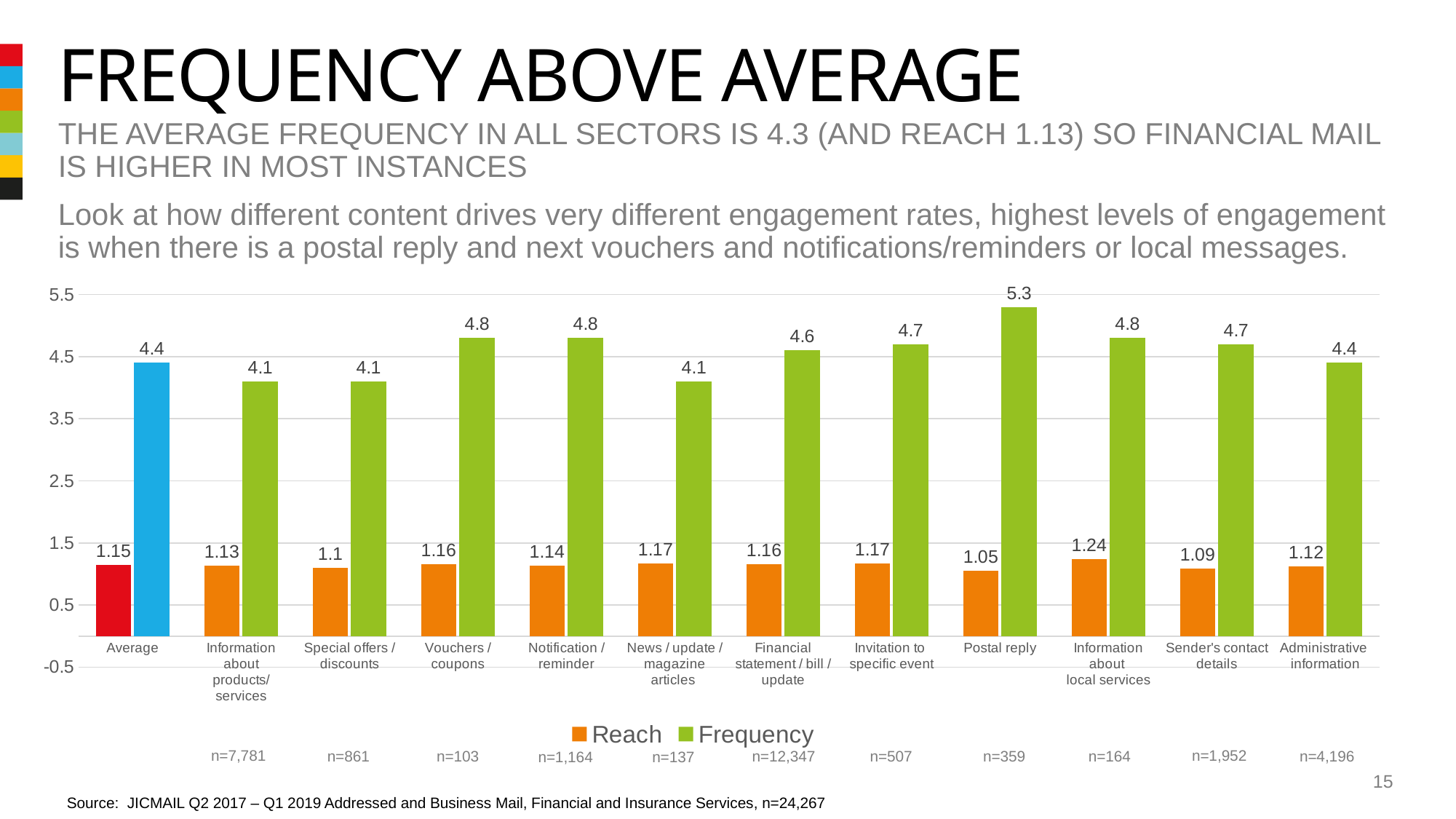
What is the Frequency value for Postal reply? 5.3 Which category has the lowest Reach value? Postal reply How many series does the legend list? 2 What is the difference between the Frequency value for Postal reply and the Frequency value for Average? 0.9 How many categories are shown on the x axis of the chart? 12 Is the Frequency value for Postal reply greater or less than 5? greater What is the difference between the Reach value for Information about local services and the Reach value for Postal reply? 0.19 What is the Frequency value for Financial statement / bill / update? 4.6 Which category has the highest Frequency value? Postal reply What kind of chart is shown on the slide? Bar chart Which is larger, the Frequency value for Vouchers / coupons or the Frequency value for Special offers / discounts? Vouchers / coupons What is the Reach value for Information about local services? 1.24